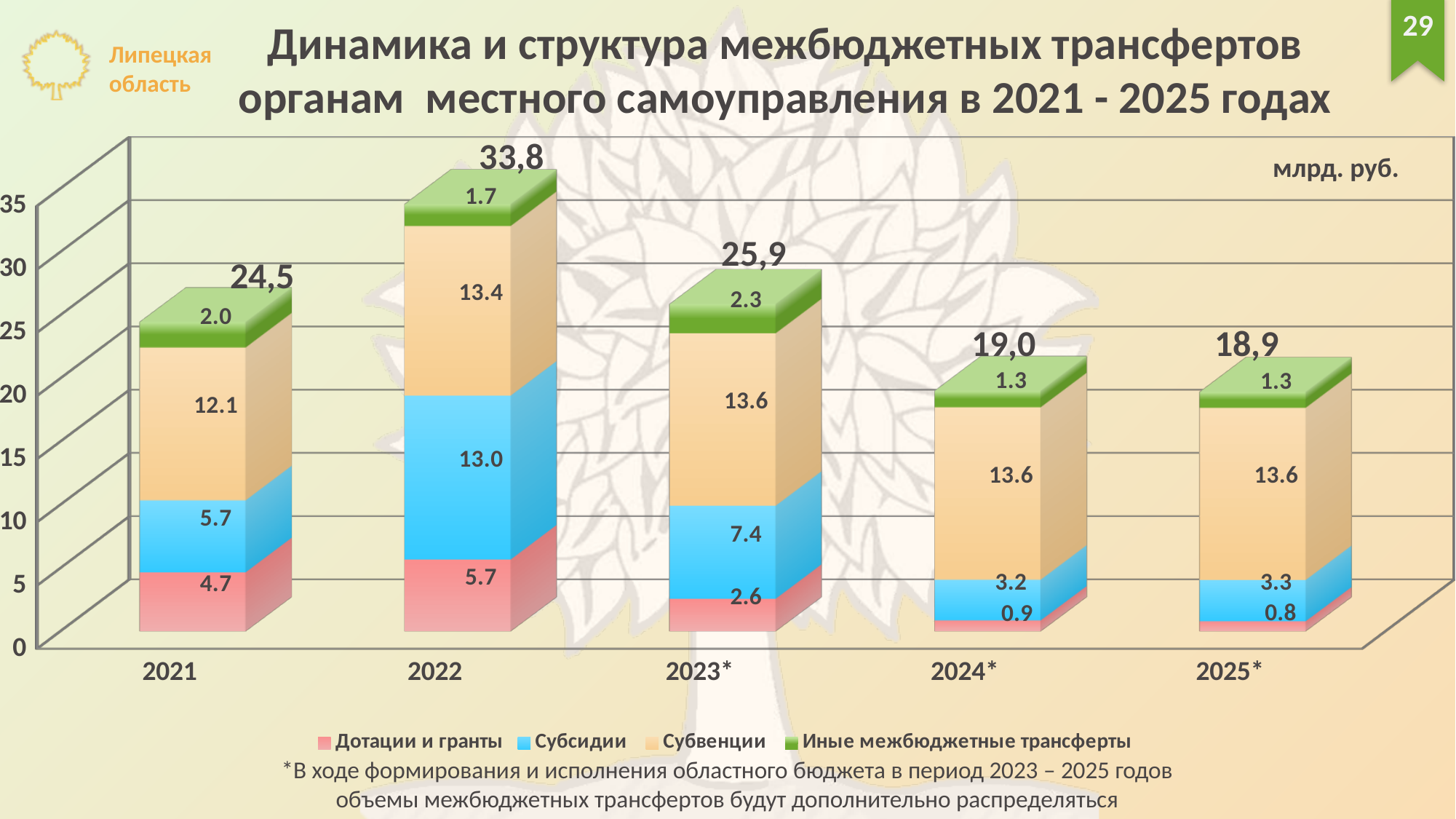
How many years (categories) are shown on the x axis? 5 Which is larger: Иные межбюджетные трансферты in 2023* or in 2021? 2023* What is the value of Субвенции for 2021? 12.1 How many series does the legend list? 4 What unit of measurement is indicated on the chart? млрд. руб. What is the total value of the bar for 2022? 33,8 What is the value of Дотации и гранты for 2025*? 0.8 Which year has the highest total of intergovernmental transfers? 2022 What type of chart is shown on the slide? Stacked bar chart What is the difference between the Субсидии values for 2022 and 2021? 7.3 What is the value of Субсидии for 2023*? 7.4 Which year has the lowest total of intergovernmental transfers? 2025*